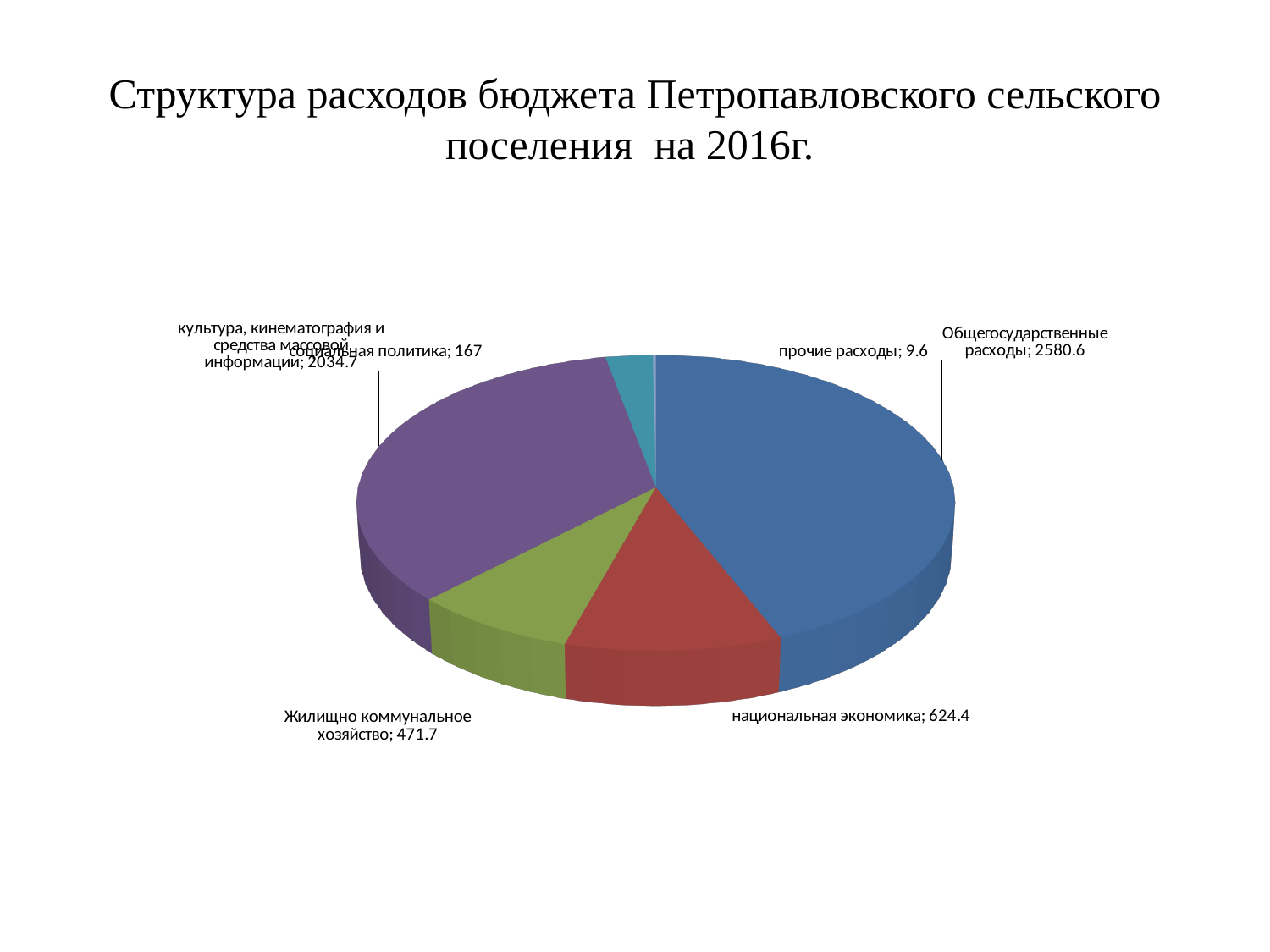
How many slices does the pie chart have? 6 What is the value for прочие расходы? 9.6 Which category has the largest value? Общегосударственные расходы What is the difference between национальная экономика and Жилищно коммунальное хозяйство? 152.7 Which is larger, национальная экономика or Жилищно коммунальное хозяйство? национальная экономика What is the difference between Общегосударственные расходы and культура, кинематография и средства массовой информации? 545.9 What is the value for социальная политика? 167 Which category has the smallest value? прочие расходы What kind of chart is shown on the slide? pie chart What is the value for Жилищно коммунальное хозяйство? 471.7 What is the value for национальная экономика? 624.4 What is the value for Общегосударственные расходы? 2580.6